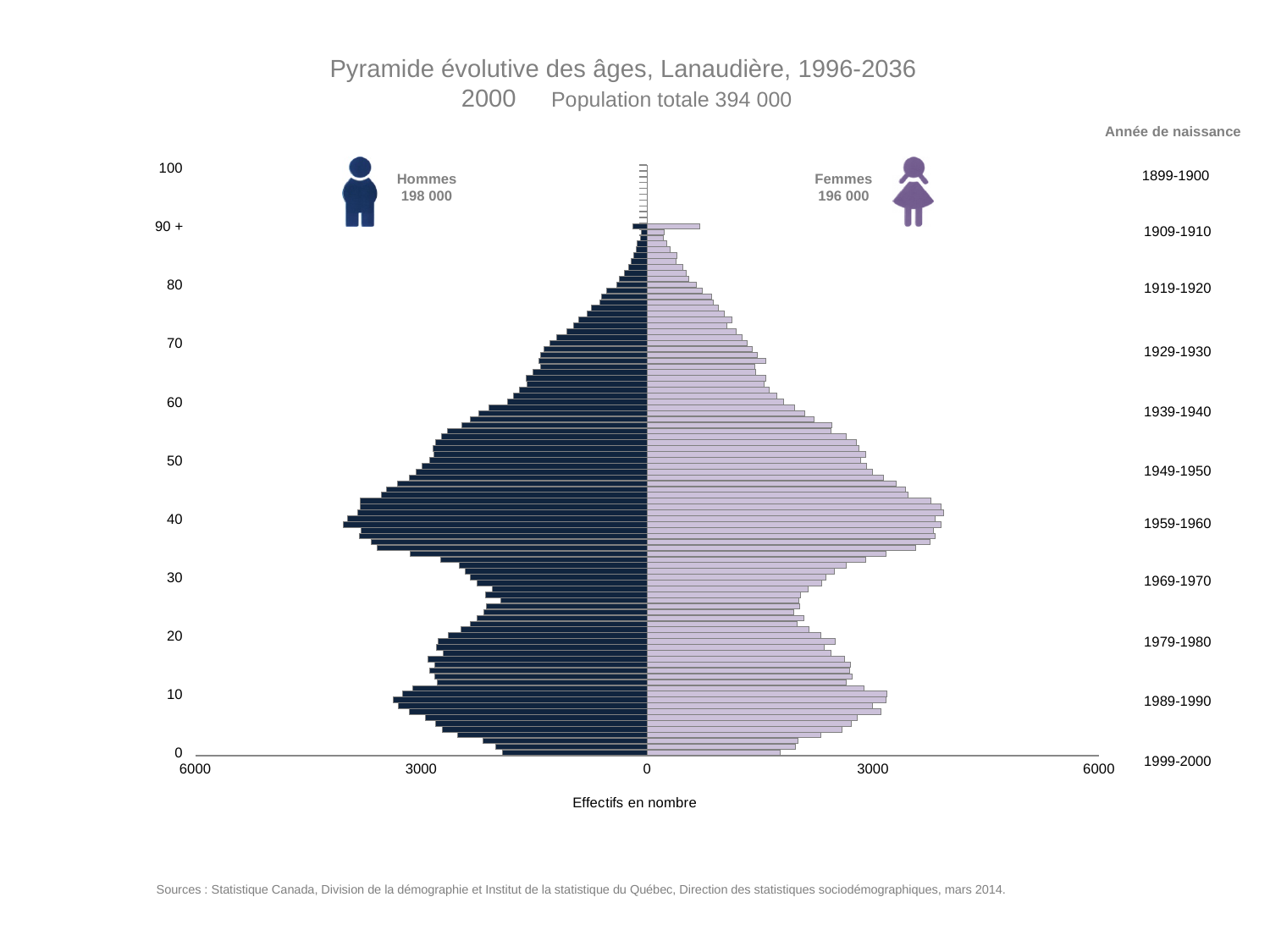
How many women (Femmes) are shown in the pyramid? 196 000 How many series (population groups) does the pyramid show? 2 Is the value for men aged 40 greater or less than 3000? greater How many men (Hommes) are shown in the pyramid? 198 000 What is the difference between the number of Hommes and the number of Femmes? 2 000 What is the title of the horizontal axis? Effectifs en nombre Around which age are the bars longest in the pyramid? 40 What kind of chart is shown on the slide? Bar chart (population pyramid) Is the value for women aged 25 greater or less than 3000? less Is the value for men aged 70 greater or less than 3000? less What is the total population shown for Lanaudière in 2000? 394 000 Which group is larger, Hommes or Femmes? Hommes